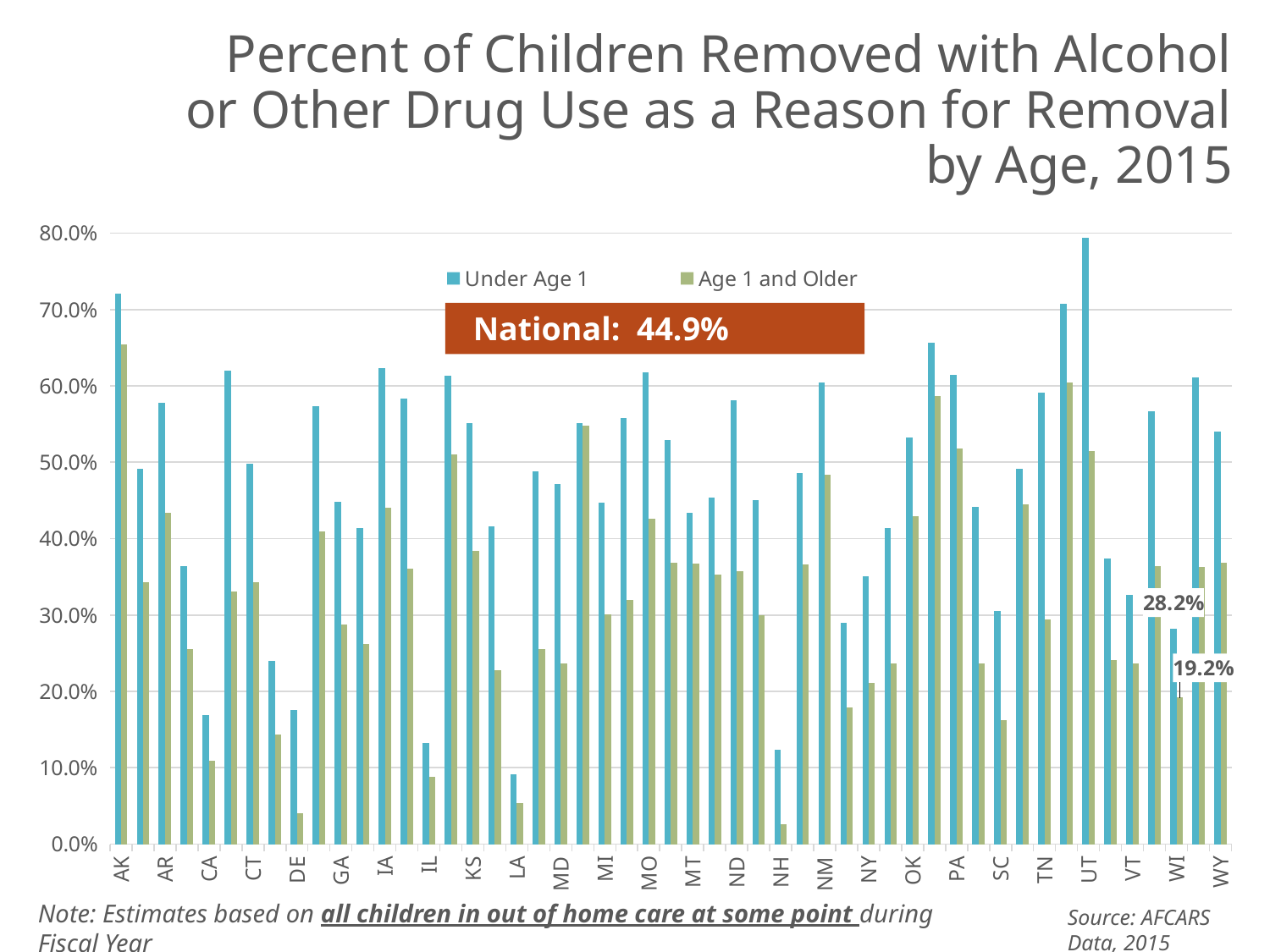
Which state has the highest Under Age 1 value? UT Is the Under Age 1 value for DE greater or less than 20%? less Is the Under Age 1 value for AK greater or less than 70%? greater What is the Age 1 and Older value for WI? 19.2% What are the two series named in the legend? Under Age 1; Age 1 and Older What kind of chart is shown on the slide? bar chart Is the Age 1 and Older value for NH greater or less than 10%? less What is the Under Age 1 value for WI? 28.2% What national percentage is shown in the box on the chart? 44.9% What is the difference between the Under Age 1 and Age 1 and Older values for WI? 9.0 percentage points How many series does the legend list? 2 For WI, which is larger: the Under Age 1 value or the Age 1 and Older value? Under Age 1